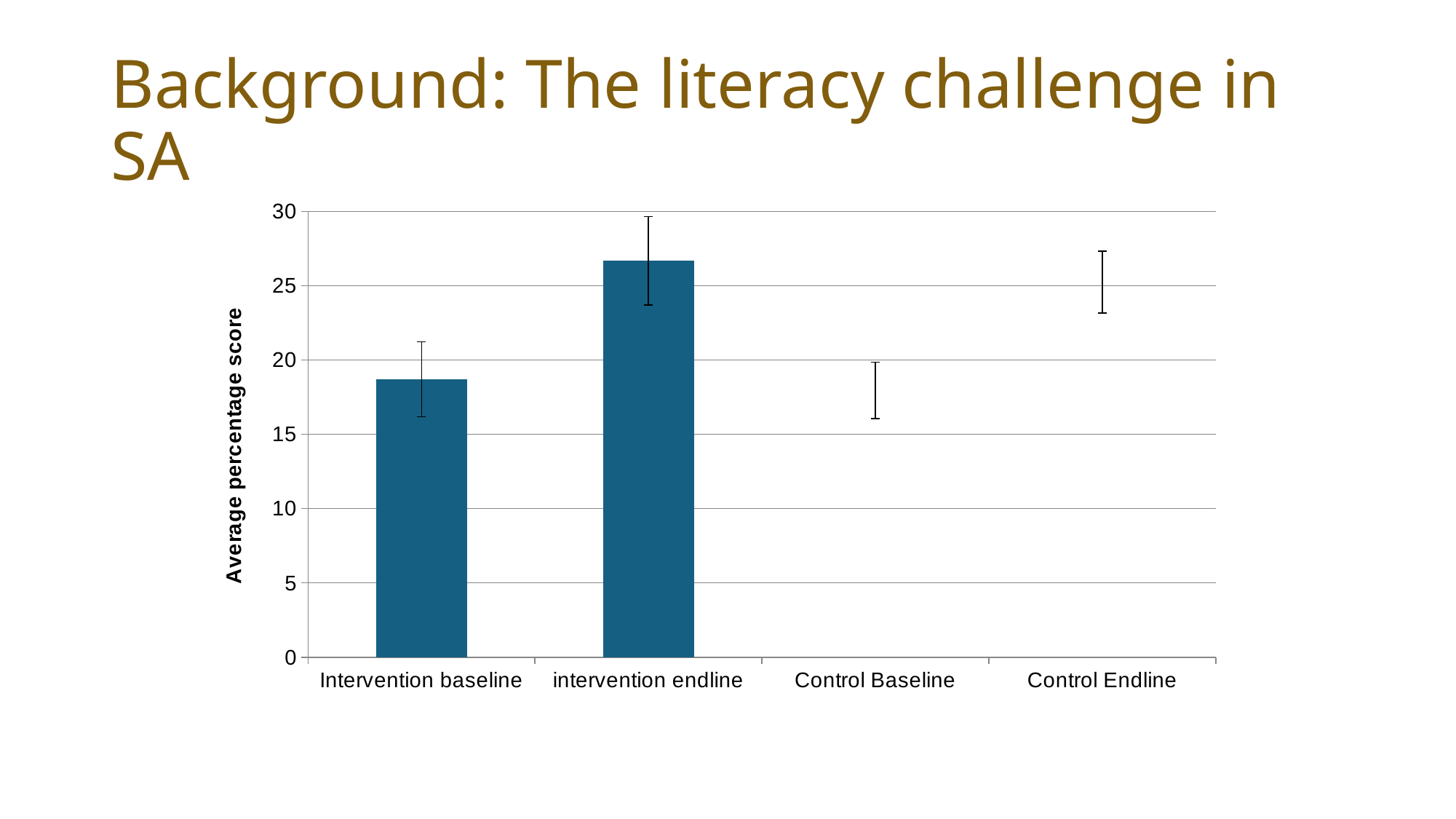
Is the value for Intervention baseline greater or less than 10? greater Is the value for intervention endline greater or less than 30? less How many categories are shown on the x axis of the chart? 4 Is the value for Intervention baseline greater or less than 15? greater What is the title of the vertical axis of the chart? Average percentage score Which is larger, the bar for Intervention baseline or the bar for intervention endline? intervention endline What is the highest value shown on the vertical axis of the chart? 30 What kind of chart is shown on the slide? bar chart Which of the two plotted bars, Intervention baseline or intervention endline, is the lower one? Intervention baseline